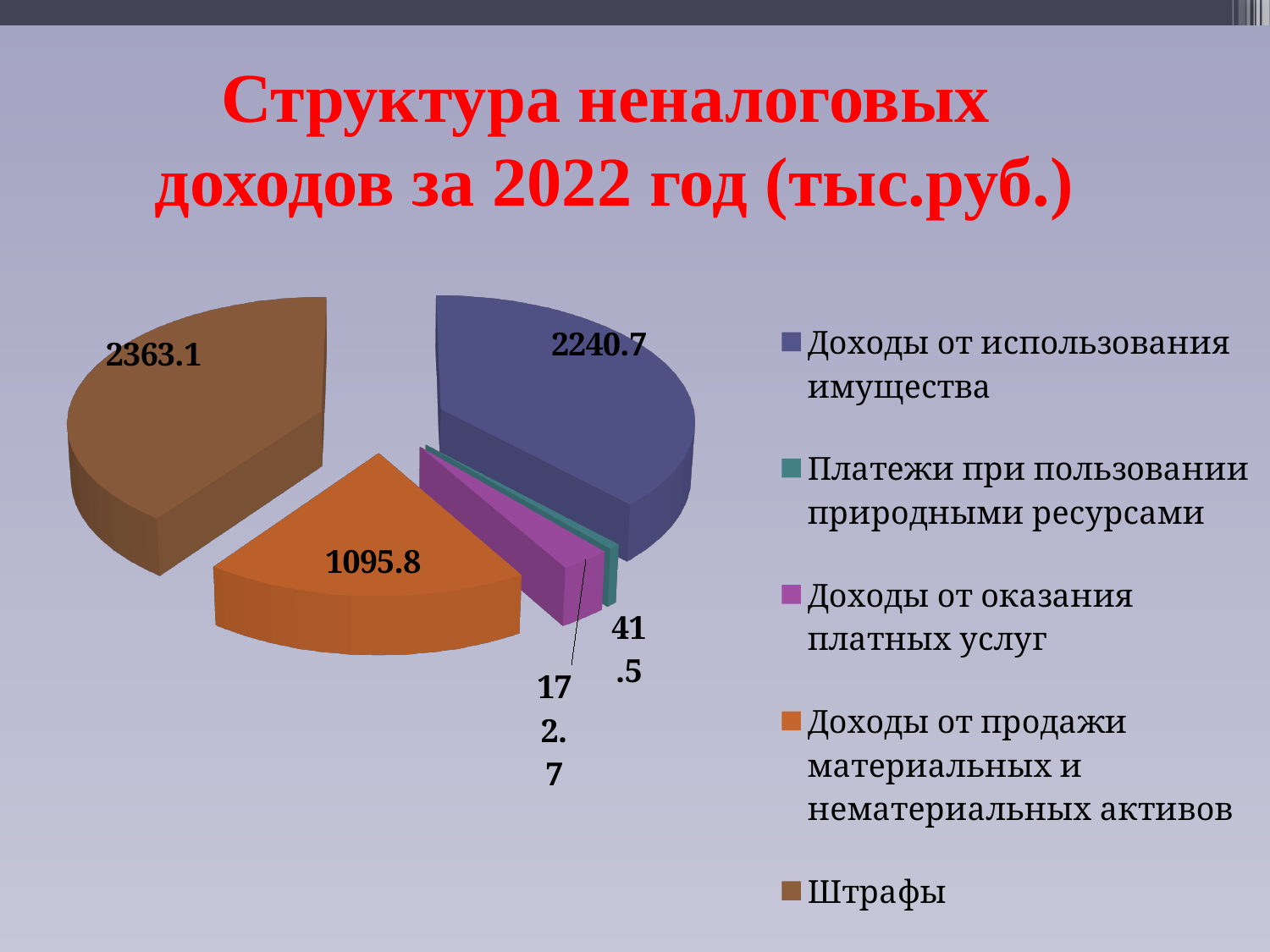
What is the value for Доходы от использования имущества? 2240.7 What is the value for Доходы от оказания платных услуг? 172.7 What is the title of the chart? Структура неналоговых доходов за 2022 год (тыс.руб.) What is the value for Доходы от продажи материальных и нематериальных активов? 1095.8 Which category has the largest value? Штрафы Which category has the smallest value? Платежи при пользовании природными ресурсами What is the difference between Штрафы and Доходы от использования имущества? 122.4 Which is larger: Доходы от оказания платных услуг or Платежи при пользовании природными ресурсами? Доходы от оказания платных услуг What is the value for Платежи при пользовании природными ресурсами? 41.5 What is the value for Штрафы? 2363.1 How many categories does the legend list? 5 What type of chart is shown on the slide? Pie chart